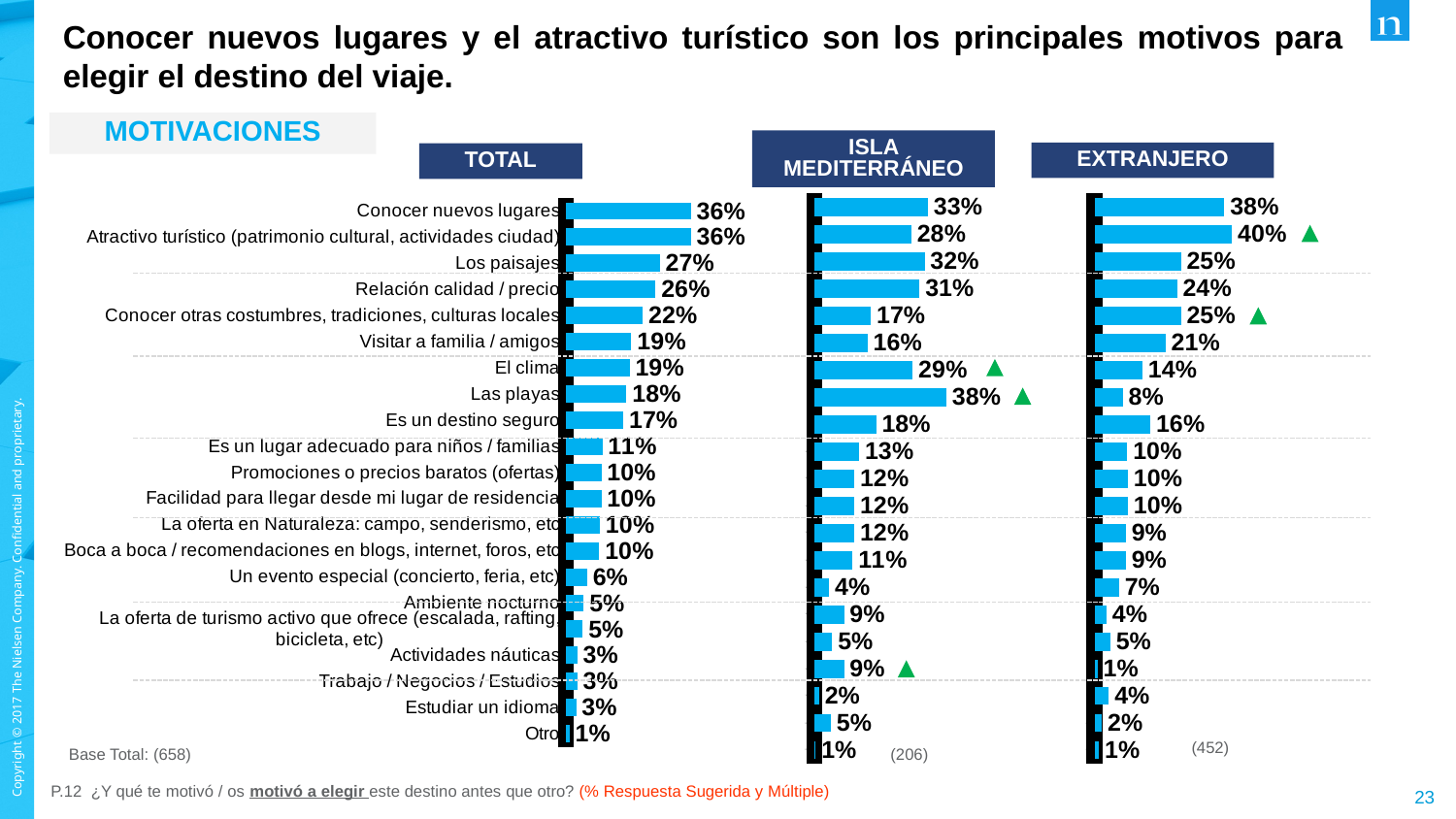
In the EXTRANJERO chart, what is the value for Atractivo turístico (patrimonio cultural, actividades ciudad)? 40% What kind of chart is the TOTAL chart? Bar chart In the ISLA MEDITERRÁNEO chart, which category has the highest value? Las playas How many categories are shown in the TOTAL chart? 21 In the ISLA MEDITERRÁNEO chart, what is the value for El clima? 29% What is the base total shown for the EXTRANJERO chart? 452 In the TOTAL chart, what is the value for Los paisajes? 27% In the TOTAL chart, what is the value for Visitar a familia / amigos? 19% Is the value for El clima larger in the ISLA MEDITERRÁNEO chart or in the EXTRANJERO chart? ISLA MEDITERRÁNEO What is the difference between the value for Las playas in the ISLA MEDITERRÁNEO chart and in the EXTRANJERO chart? 30 percentage points In the EXTRANJERO chart, which category has the highest value? Atractivo turístico (patrimonio cultural, actividades ciudad) In the TOTAL chart, which category has the lowest value? Otro